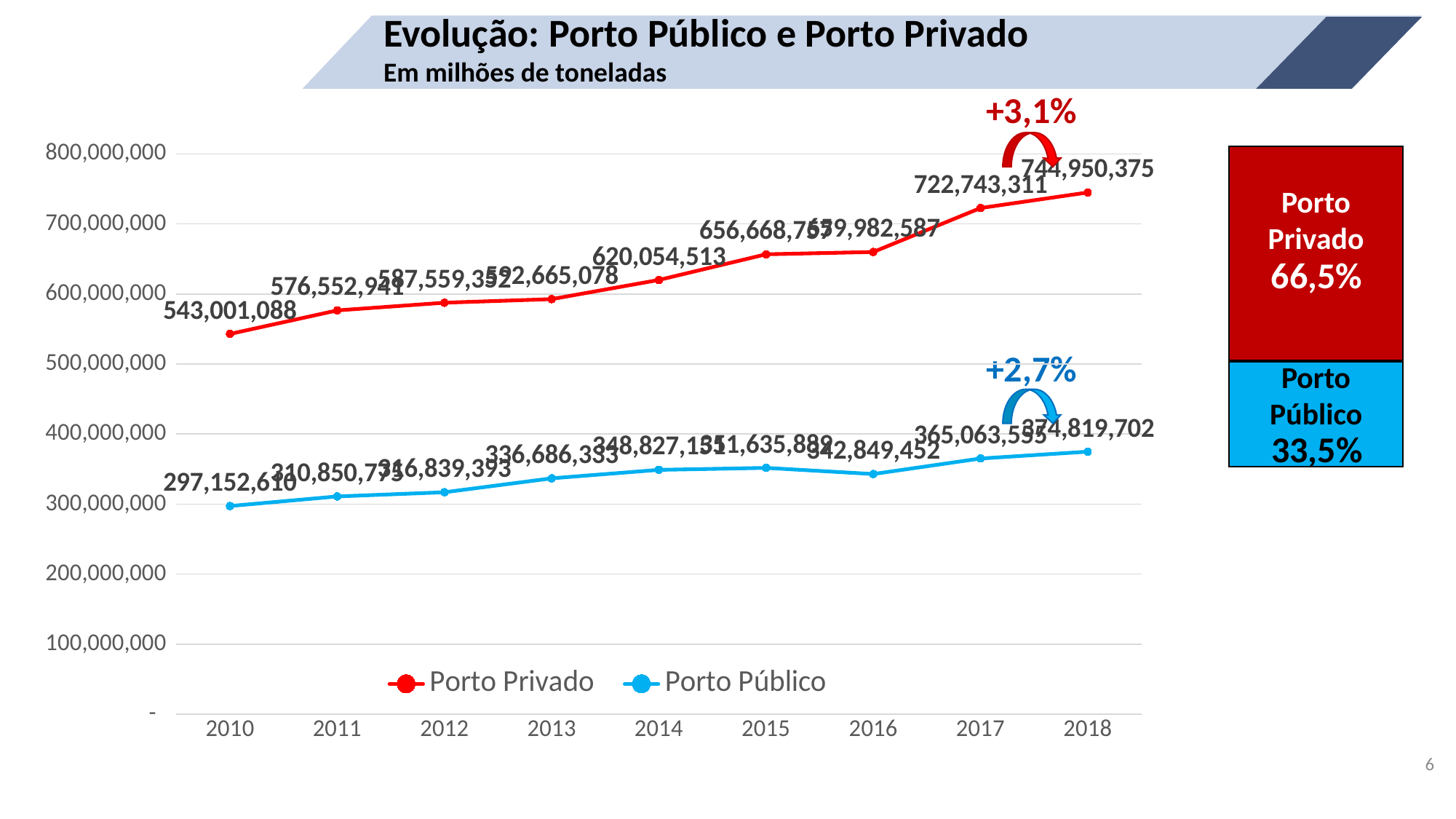
How many years are plotted along the x axis? 9 How many series does the legend list? 2 What is the value for Porto Público in 2010? 297,152,610 In which year is Porto Público lowest? 2010 What type of chart is shown on the slide? Line chart Is the value for Porto Público in 2016 greater or less than 400,000,000? less What is the value for Porto Privado in 2014? 620,054,513 What is the value for Porto Privado in 2010? 543,001,088 In which year is Porto Privado highest? 2018 What is the value for Porto Público in 2018? 374,819,702 What is the value for Porto Privado in 2018? 744,950,375 What is the difference between Porto Privado in 2018 and in 2017? 22,207,064